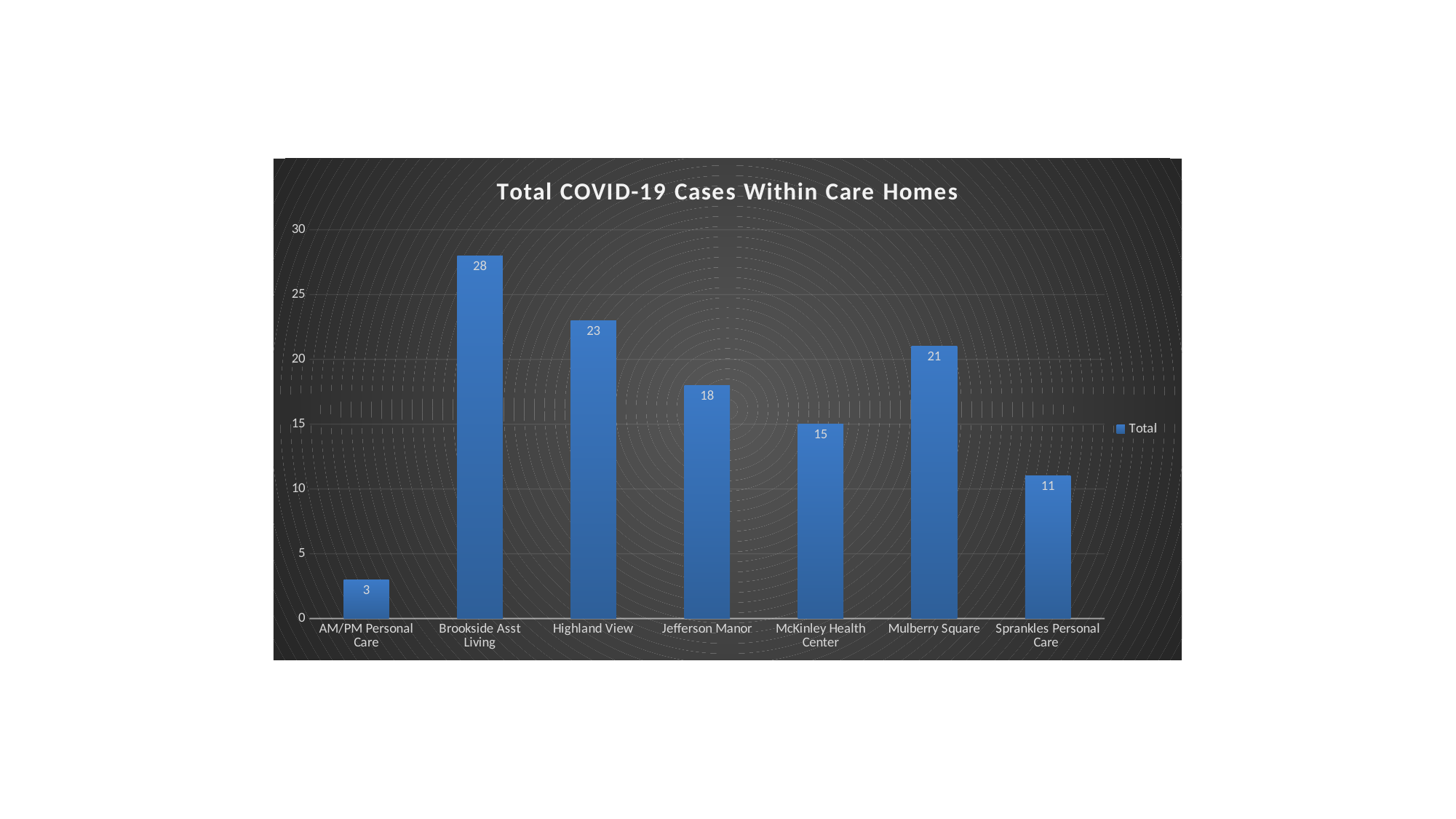
What kind of chart is shown on the slide? Bar chart What is the difference in cases between Highland View and Jefferson Manor? 5 How many care homes are shown on the chart? 7 What is the title of the chart? Total COVID-19 Cases Within Care Homes What is the value shown for McKinley Health Center? 15 How many series does the legend list? 1 Which has more cases, Mulberry Square or Jefferson Manor? Mulberry Square Which care home has the lowest number of COVID-19 cases? AM/PM Personal Care How many cases are shown for Sprankles Personal Care? 11 Is the value for Highland View greater or less than 20? greater Which care home has the highest number of COVID-19 cases? Brookside Asst Living What is the total number of COVID-19 cases for Brookside Asst Living? 28